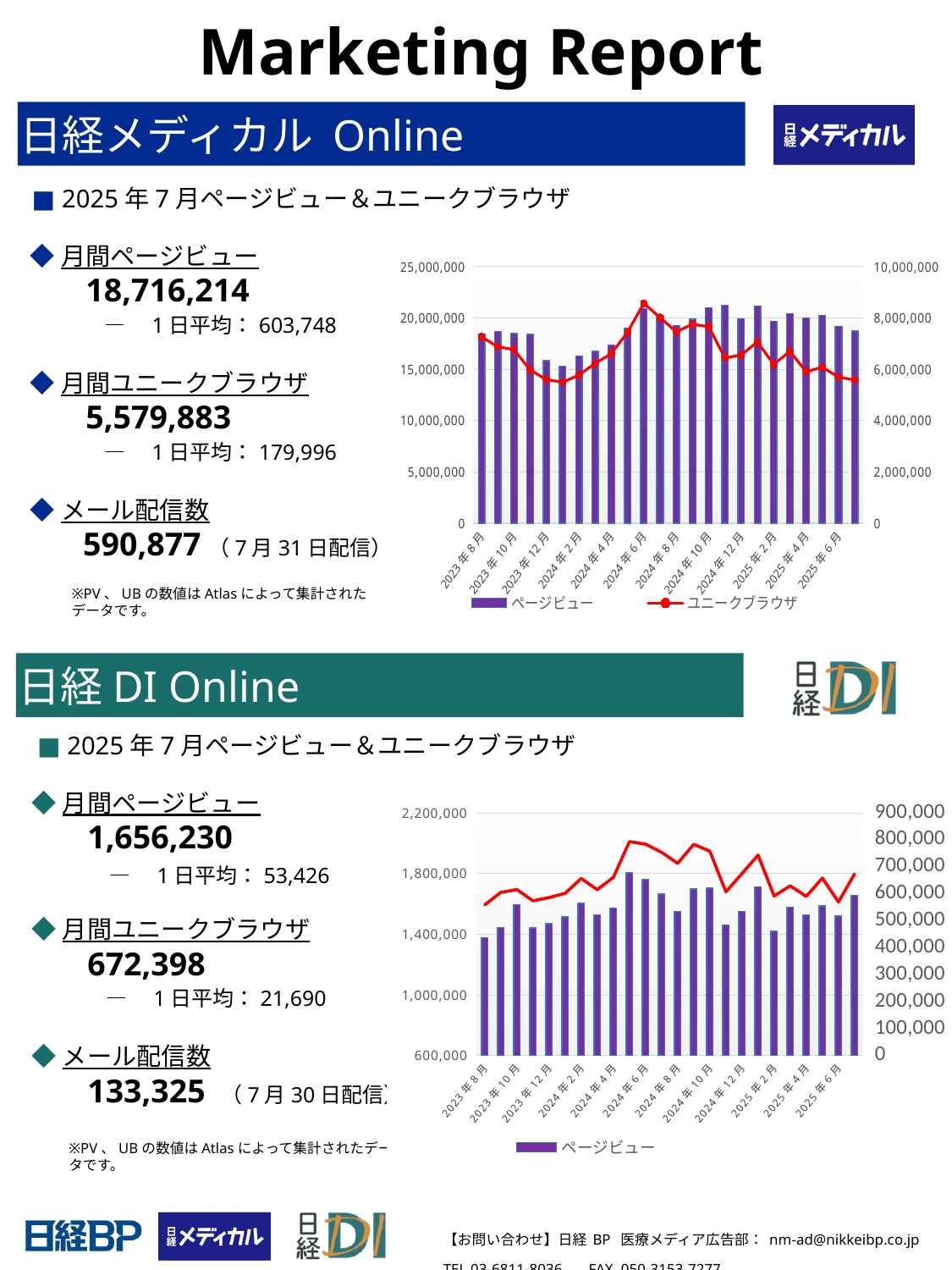
In the bottom chart (日経DI Online), which month has the highest ページビュー bar? 2024年5月 In the top chart (日経メディカル Online), is the ページビュー value for 2023年8月 greater or less than 15,000,000? greater In the top chart (日経メディカル Online), what colour is the ユニークブラウザ line? Red How many series does the legend of the top chart (日経メディカル Online) list? 2 What kind of chart is the top chart (日経メディカル Online)? Bar and line chart In the top chart (日経メディカル Online), which has the larger ページビュー bar: 2024年6月 or 2023年12月? 2024年6月 In the bottom chart (日経DI Online), is the ページビュー value for 2024年6月 greater or less than 1,400,000? greater In the top chart (日経メディカル Online), does the ユニークブラウザ line rise or fall from 2024年6月 to 2025年6月? fall In the top chart (日経メディカル Online), in which month does the ユニークブラウザ line reach its highest point? 2024年6月 In the top chart (日経メディカル Online), is the ユニークブラウザ value for 2025年6月 greater or less than 6,000,000? less In the bottom chart (日経DI Online), do the ページビュー bars generally rise or fall from 2023年8月 to 2024年6月? rise How many series does the legend of the bottom chart (日経DI Online) list? 1